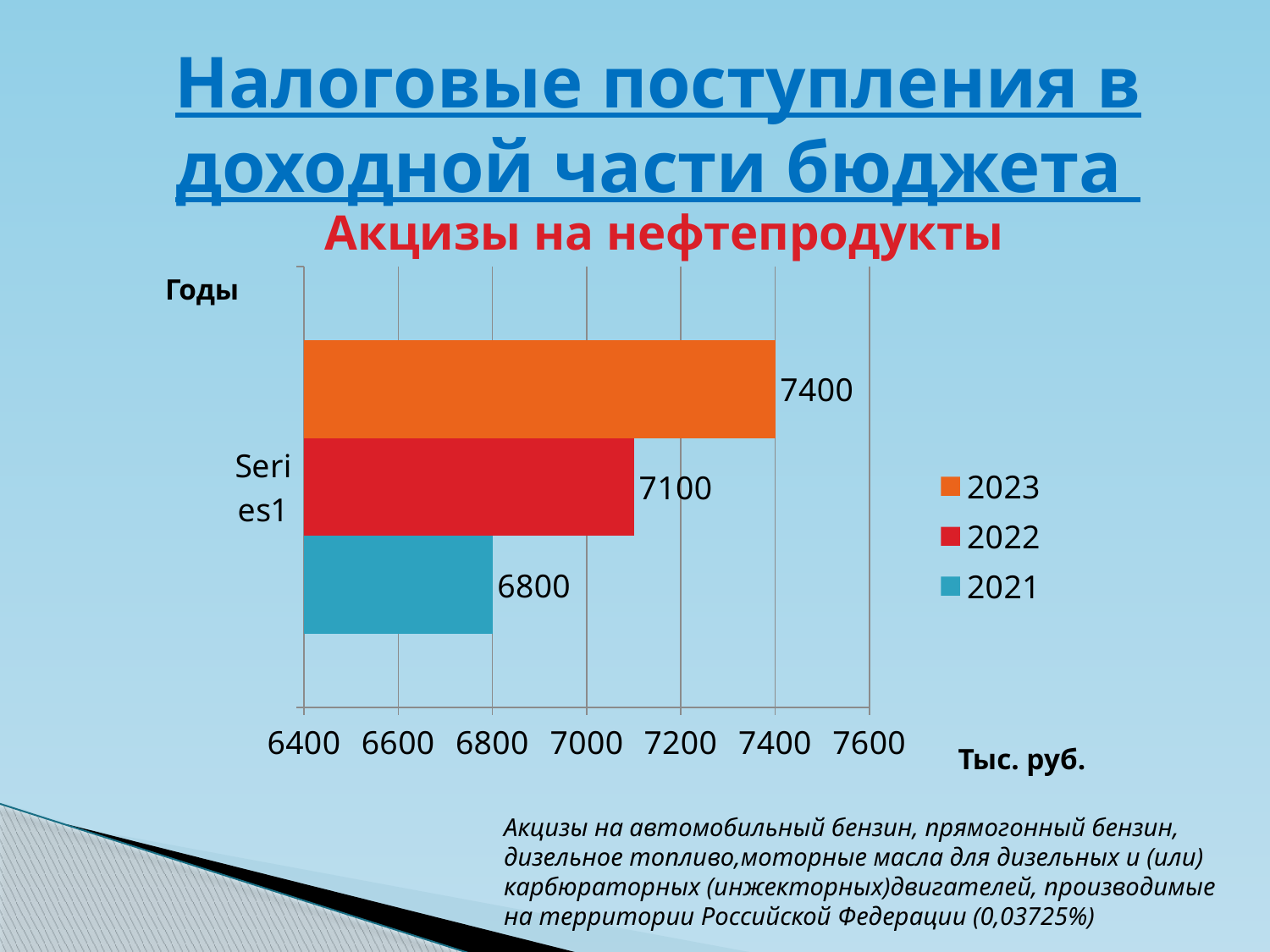
How many series does the legend list? 3 Which year has the lowest value? 2021 Which is larger, the value for 2022 or the value for 2021? 2022 Is the value for 2022 greater or less than 7000? greater What is the difference between the values for 2022 and 2021? 300 What is the value for 2023? 7400 What is the title of the chart? Акцизы на нефтепродукты Which year has the highest value? 2023 What is the value for 2021? 6800 What kind of chart is shown on the slide? bar chart What is the difference between the values for 2023 and 2021? 600 What is the value for 2022? 7100